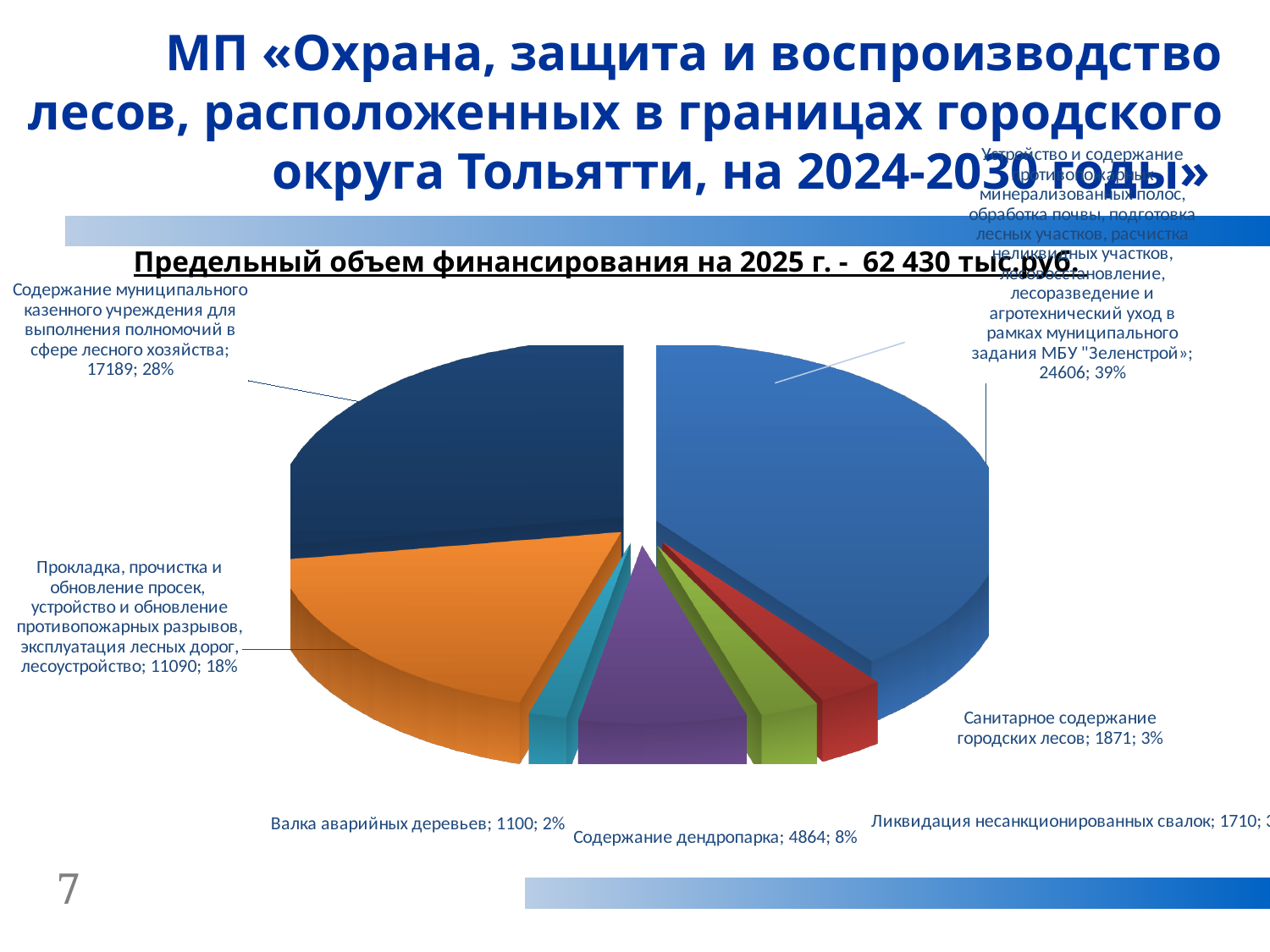
How many slices does the pie chart have? 7 What is the value for "Ликвидация несанкционированных свалок"? 1710 Which is larger: the value for "Прокладка, прочистка и обновление просек..." or the value for "Содержание дендропарка"? Прокладка, прочистка и обновление просек... What is the value for "Содержание дендропарка"? 4864 What is the largest value shown on the pie chart? 24606 What share of the pie does "Содержание муниципального казенного учреждения для выполнения полномочий в сфере лесного хозяйства" represent? 28% What is the value for "Валка аварийных деревьев"? 1100 What is the difference between the values for "Содержание дендропарка" and "Санитарное содержание городских лесов"? 2993 Which category has the smallest value? Валка аварийных деревьев What is the value for "Санитарное содержание городских лесов"? 1871 What share of the pie does the slice for the municipal task of МБУ "Зеленстрой" represent? 39% What kind of chart is shown on the slide? pie chart